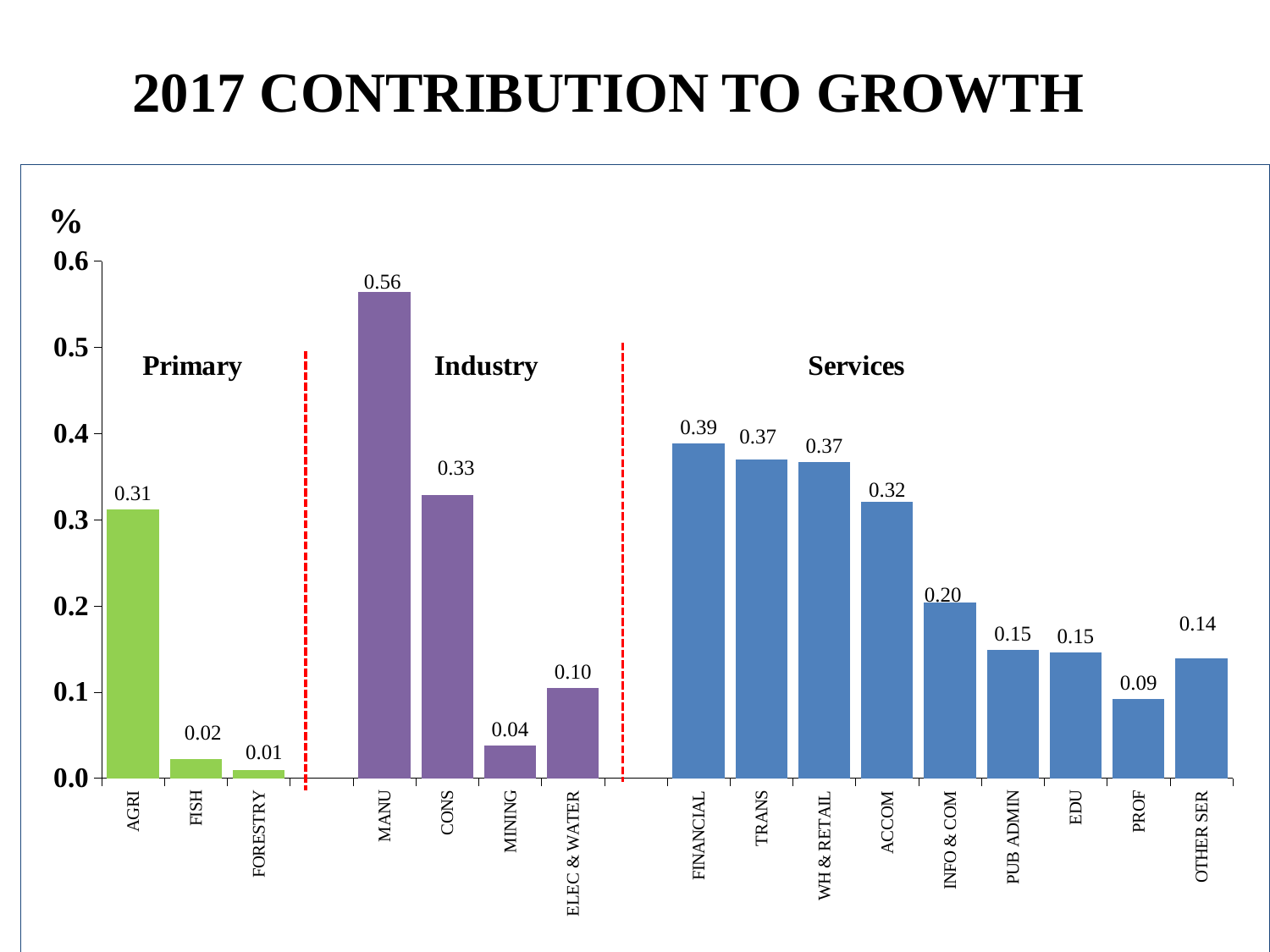
What is the difference between the values for MANU and CONS? 0.23 What is the value for INFO & COM? 0.20 What kind of chart is shown on the slide? bar chart What is the value for MANU? 0.56 Which is larger, the value for ACCOM or the value for ELEC & WATER? ACCOM Is the value for CONS greater or less than 0.3? greater What is the difference between the values for AGRI and FISH? 0.29 Which category has the highest value? MANU Which category has the lowest value? FORESTRY How many categories are shown on the chart? 16 What is the title of the chart? 2017 CONTRIBUTION TO GROWTH What is the value for FINANCIAL? 0.39